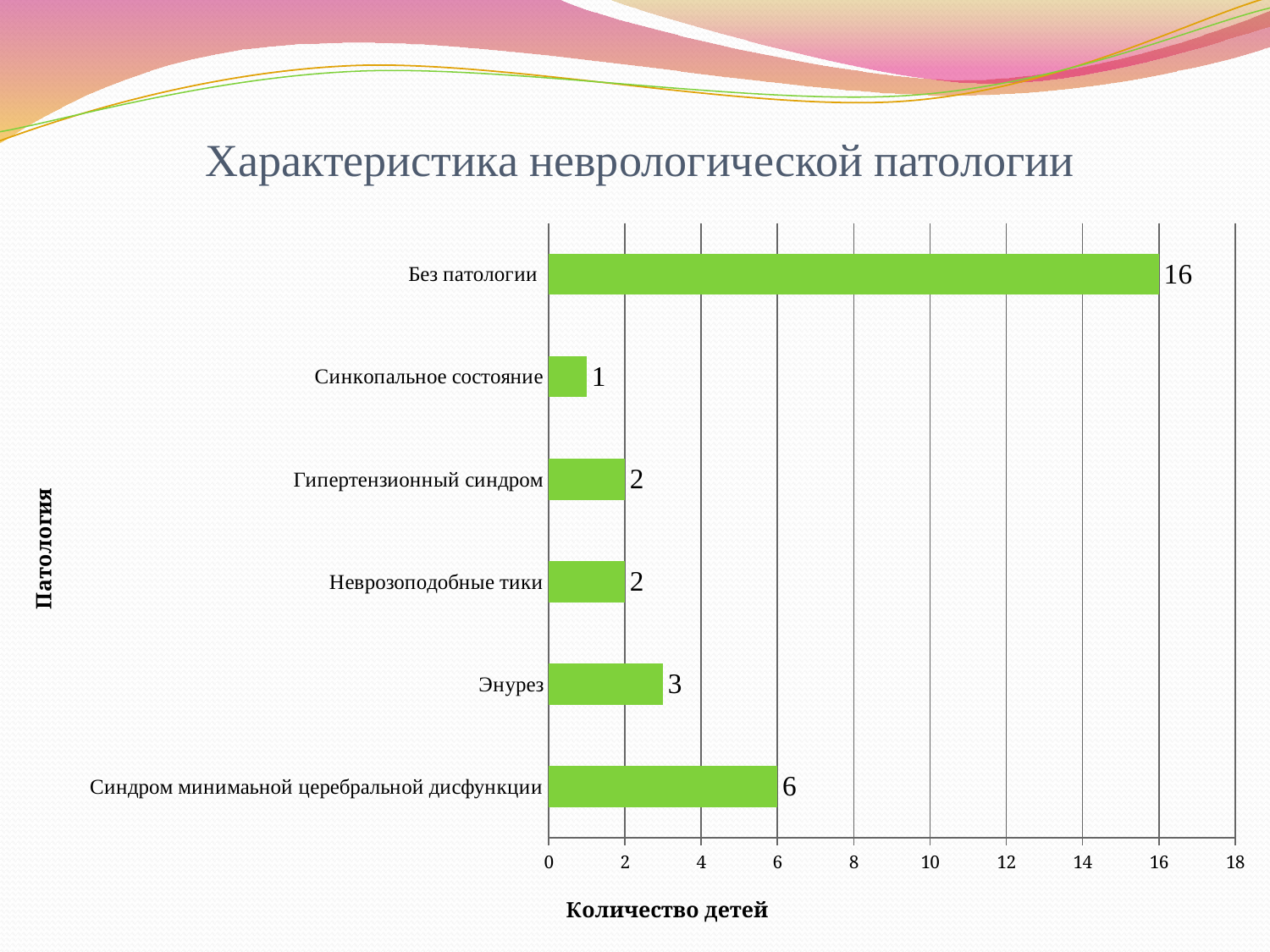
What kind of chart is shown on the slide? Bar chart Which is larger, the value for Энурез or the value for Гипертензионный синдром? Энурез What is the difference between the values for Без патологии and Синдром минимаьной церебральной дисфункции? 10 What is the value for Без патологии? 16 Which category has the lowest value? Синкопальное состояние Which category has the highest value? Без патологии What is the value for Синдром минимаьной церебральной дисфункции? 6 What is the value for Энурез? 3 What is the title of the chart? Характеристика неврологической патологии What is the value for Синкопальное состояние? 1 How many categories are shown in the chart? 6 What is the label of the horizontal axis? Количество детей